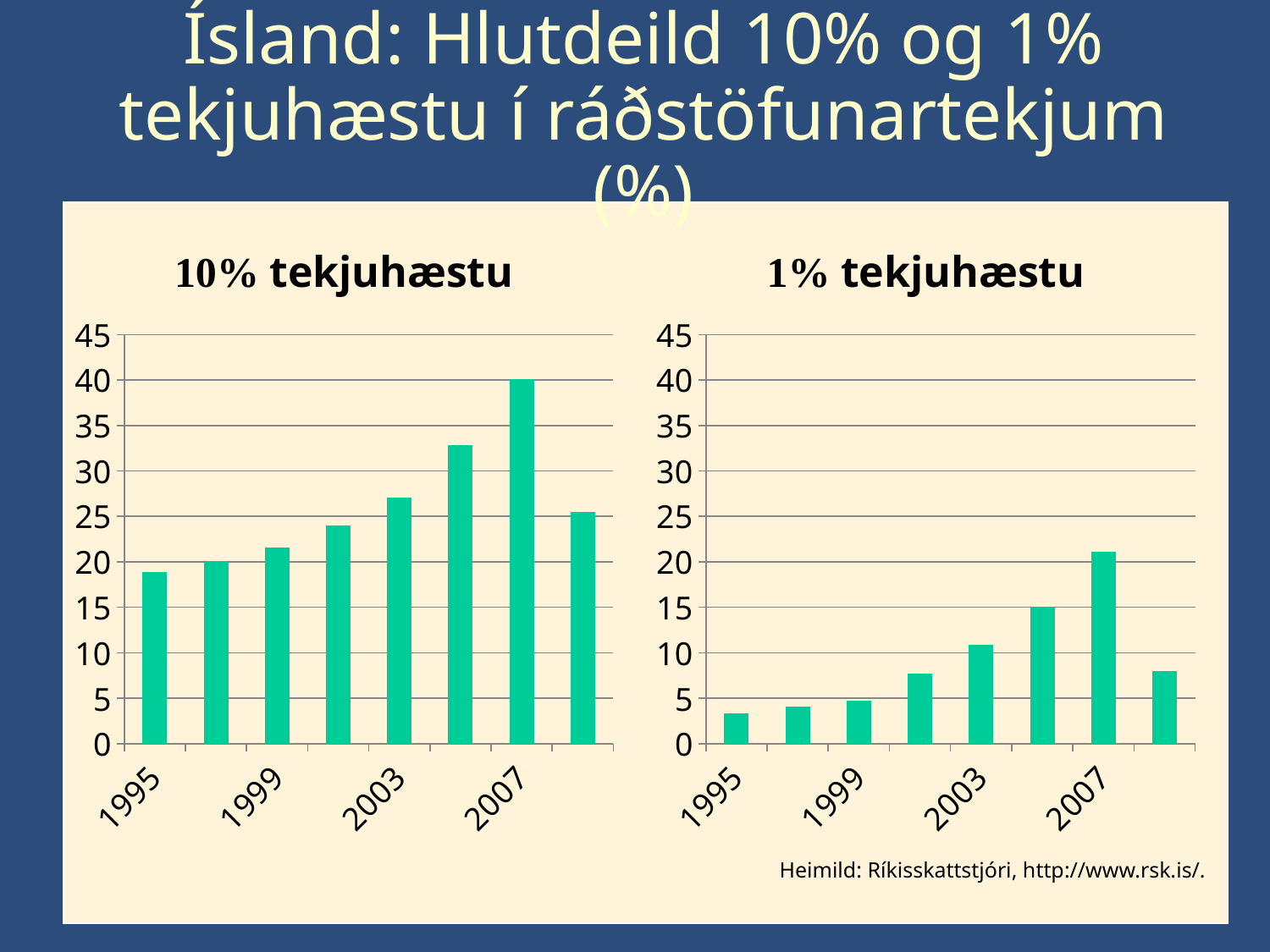
What is the highest value shown on the vertical axis of the "10% tekjuhæstu" chart? 45 In the "1% tekjuhæstu" chart, is the value for 1995 greater or less than 5? less What kind of chart is the "10% tekjuhæstu" chart? bar chart In the "10% tekjuhæstu" chart, is the value for 1995 greater or less than 20? less In the "1% tekjuhæstu" chart, which labelled year has the lowest bar? 1995 In the "10% tekjuhæstu" chart, which labelled year has the highest bar? 2007 What is the title of the chart on the right side of the slide? 1% tekjuhæstu In the "1% tekjuhæstu" chart, is the value for 2007 greater or less than 20? greater In the "1% tekjuhæstu" chart, which is larger, the value for 2003 or the value for 1999? 2003 How many bars are plotted in the "1% tekjuhæstu" chart? 8 In the "10% tekjuhæstu" chart, do the values rise or fall from 1995 to 2007? rise